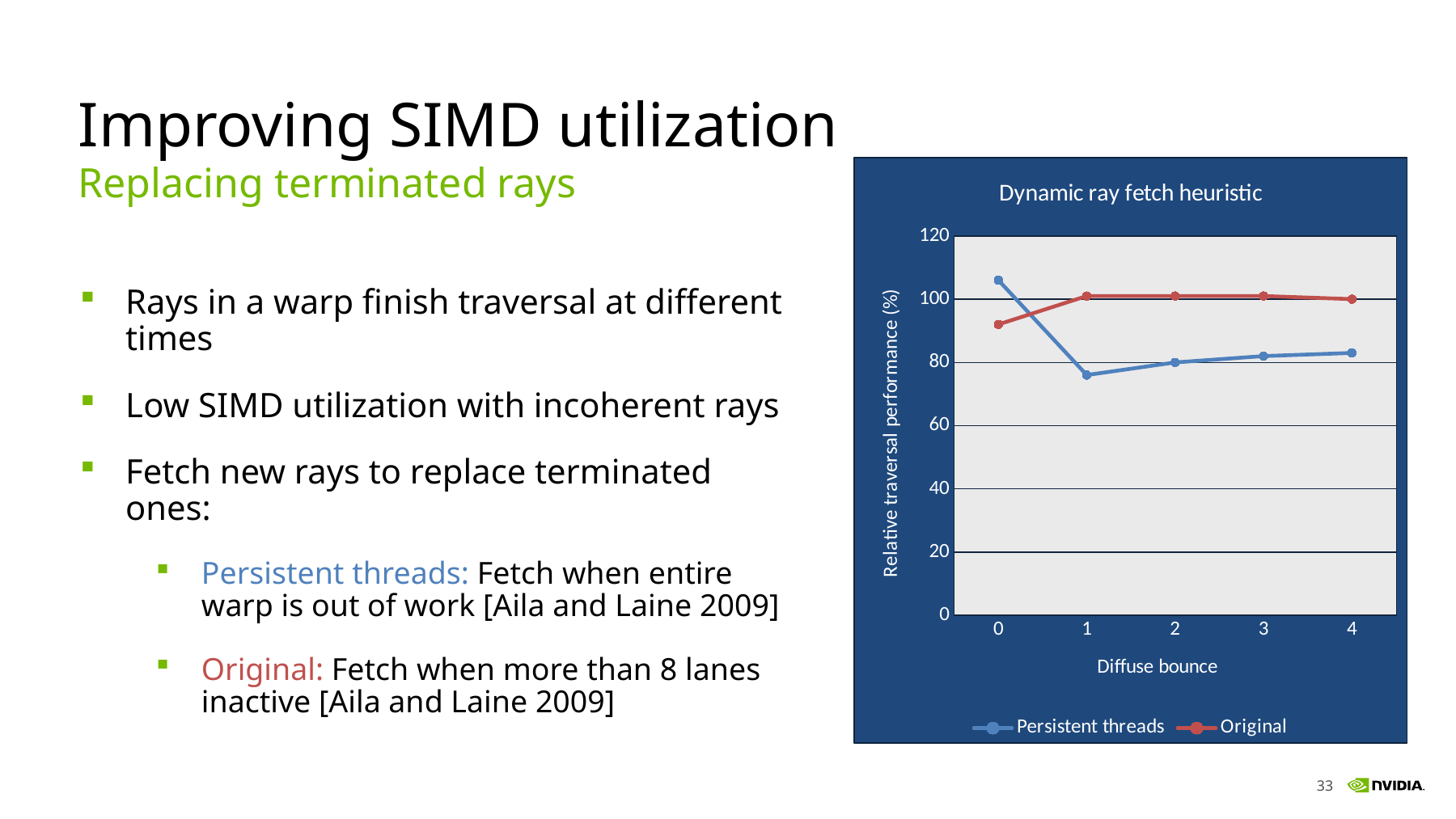
At which diffuse bounce does the Persistent threads series reach its lowest value? 1 Is the value for Persistent threads at diffuse bounce 0 greater or less than 100? greater Is the value for Persistent threads at diffuse bounce 1 greater or less than 80? less What is the title of the chart? Dynamic ray fetch heuristic Is the value for Original at diffuse bounce 2 greater or less than 80? greater What kind of chart is shown on the slide? line chart What is the label of the y axis of the chart? Relative traversal performance (%) At diffuse bounce 3, which series has the higher value, Persistent threads or Original? Original How many diffuse bounce values are plotted along the x axis of the chart? 5 At diffuse bounce 0, which series has the higher value, Persistent threads or Original? Persistent threads How many series does the legend of the chart list? 2